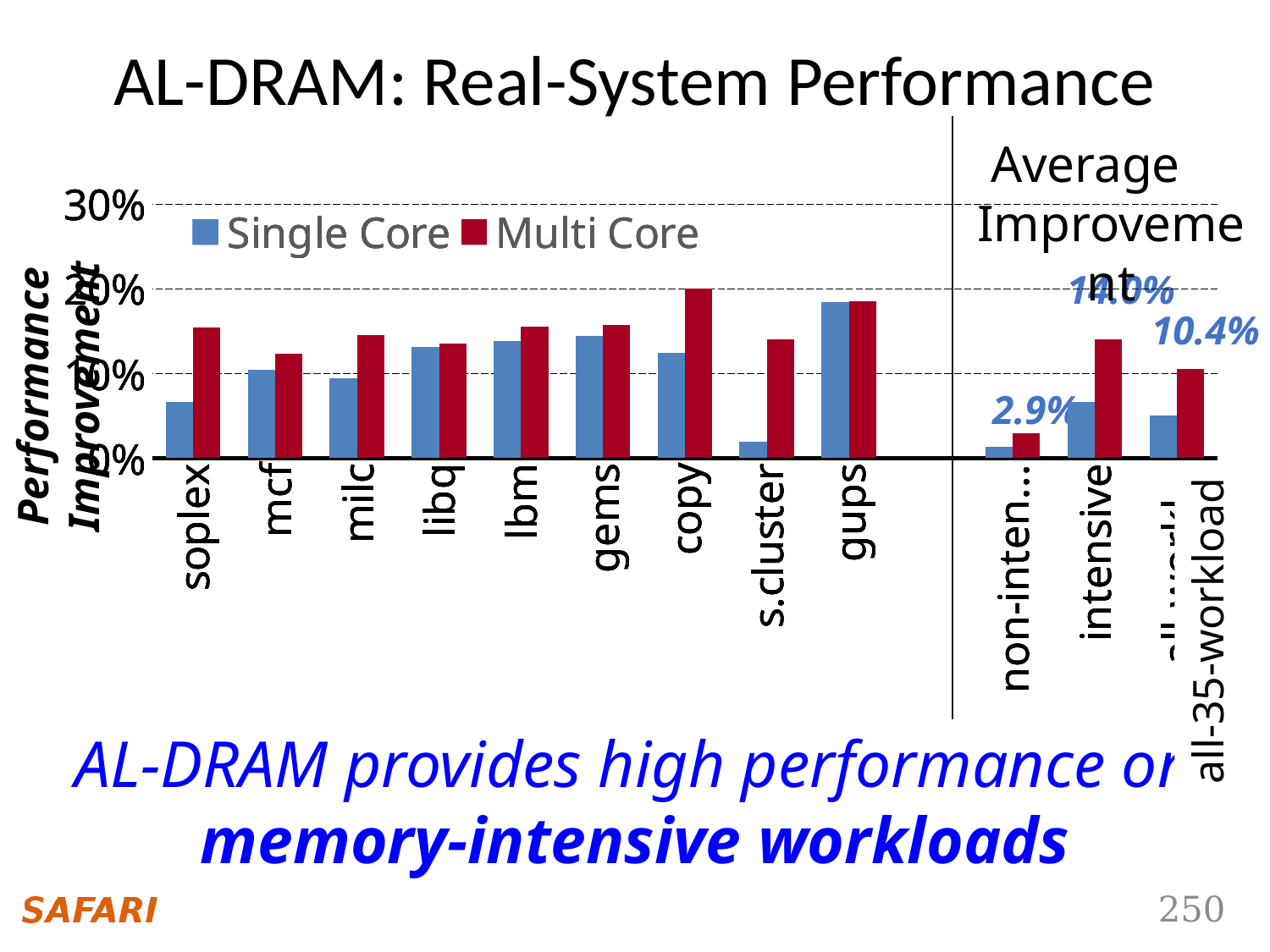
What is the labelled Multi Core value for the intensive category? 14.0% What is the difference between the labelled Multi Core values for intensive (14.0%) and all-35-workload (10.4%)? 3.6% Is the Single Core value for s.cluster greater or less than 10%? less Is the Single Core value for gups greater or less than 10%? greater What kind of chart is shown on the slide? bar chart How many series does the legend list? 2 Which of the nine benchmark categories left of the divider has the lowest Single Core value? s.cluster For soplex, which is larger: the Single Core value or the Multi Core value? Multi Core Which of the nine benchmark categories left of the divider has the highest Single Core value? gups How many categories are shown along the x axis? 12 What is the labelled Multi Core value for the all-35-workload category? 10.4% What colour represents the Multi Core series in the legend? red